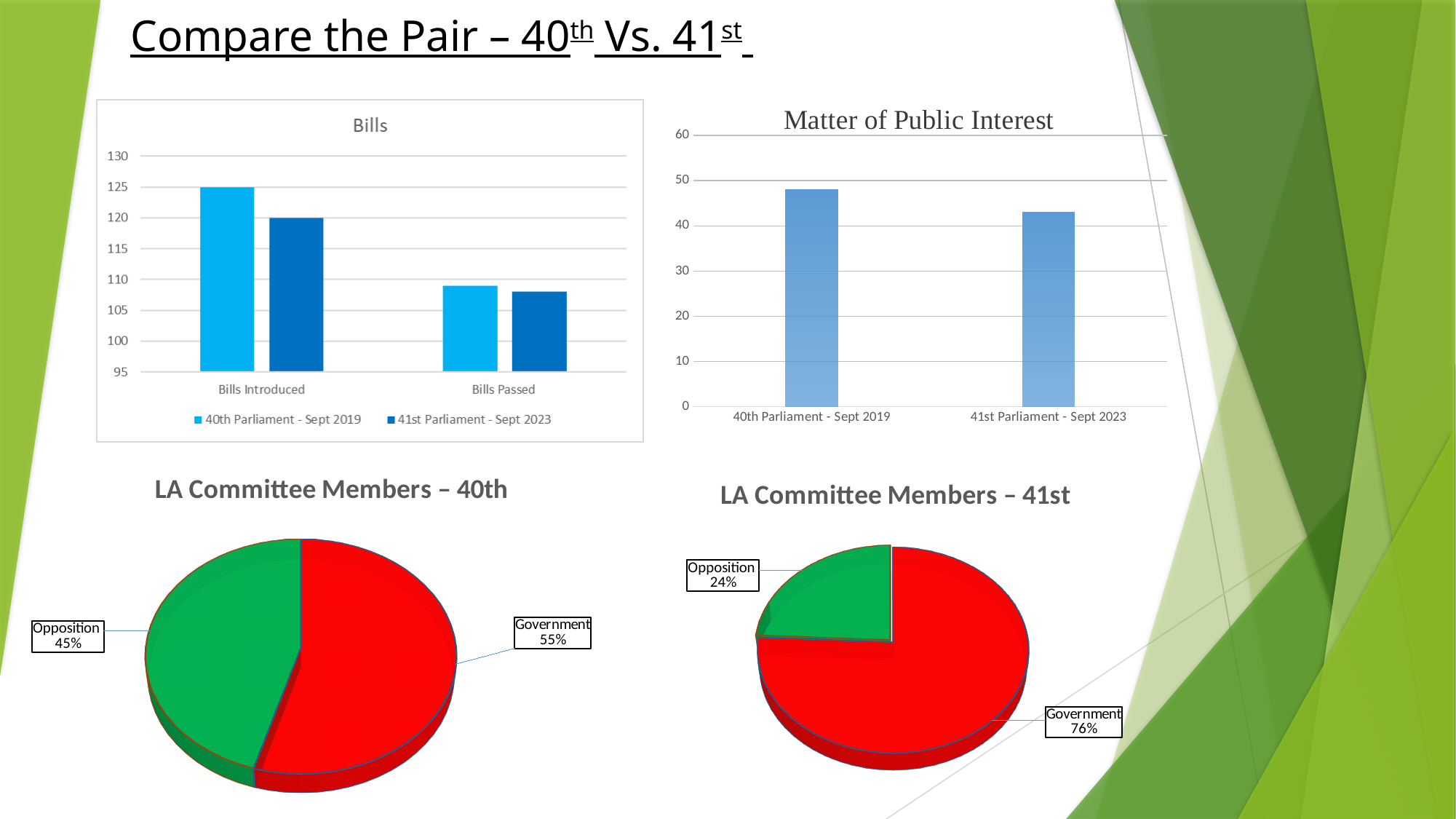
In the Bills chart, what is the value for Bills Introduced in the 40th Parliament - Sept 2019? 125 In the LA Committee Members – 41st chart, what share of the pie is Government? 76% What kind of chart is the LA Committee Members – 41st chart? Pie chart In the Bills chart, what is the difference between Bills Introduced in the 40th Parliament and in the 41st Parliament? 5 In the LA Committee Members – 40th chart, what share of the pie is Opposition? 45% In the Matter of Public Interest chart, which parliament has the higher bar? 40th Parliament - Sept 2019 In the Bills chart, what is the value for Bills Introduced in the 41st Parliament - Sept 2023? 120 In the Bills chart, which category has the higher values, Bills Introduced or Bills Passed? Bills Introduced In the Bills chart, is the value for Bills Passed in the 40th Parliament - Sept 2019 greater or less than 105? greater In the Matter of Public Interest chart, is the value for 40th Parliament - Sept 2019 greater or less than 40? greater In the Bills chart, how many series does the legend list? 2 In the Matter of Public Interest chart, is the value for 41st Parliament - Sept 2023 greater or less than 50? less